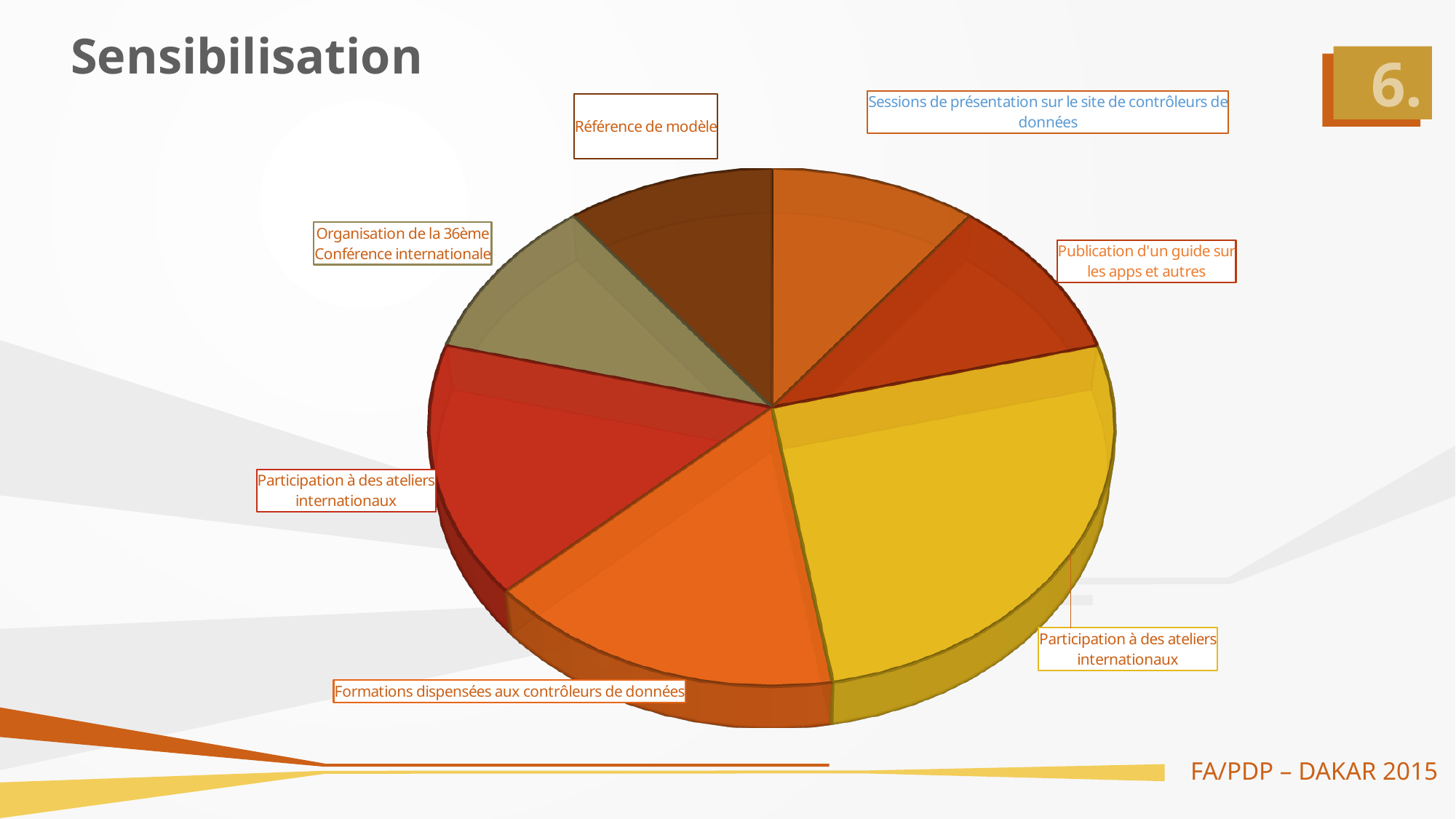
Which slice is larger: the yellow "Participation à des ateliers internationaux" slice or "Organisation de la 36ème Conférence internationale"? Participation à des ateliers internationaux How many slices does the pie chart have? 7 What is the title of the slide containing the pie chart? Sensibilisation What colour is the largest slice of the pie chart? Yellow Which slice is larger: "Formations dispensées aux contrôleurs de données" or "Référence de modèle"? Formations dispensées aux contrôleurs de données Which category has the largest slice in the pie chart? Participation à des ateliers internationaux What kind of chart is shown on the slide? Pie chart Which slice is larger: "Formations dispensées aux contrôleurs de données" or "Publication d'un guide sur les apps et autres"? Formations dispensées aux contrôleurs de données